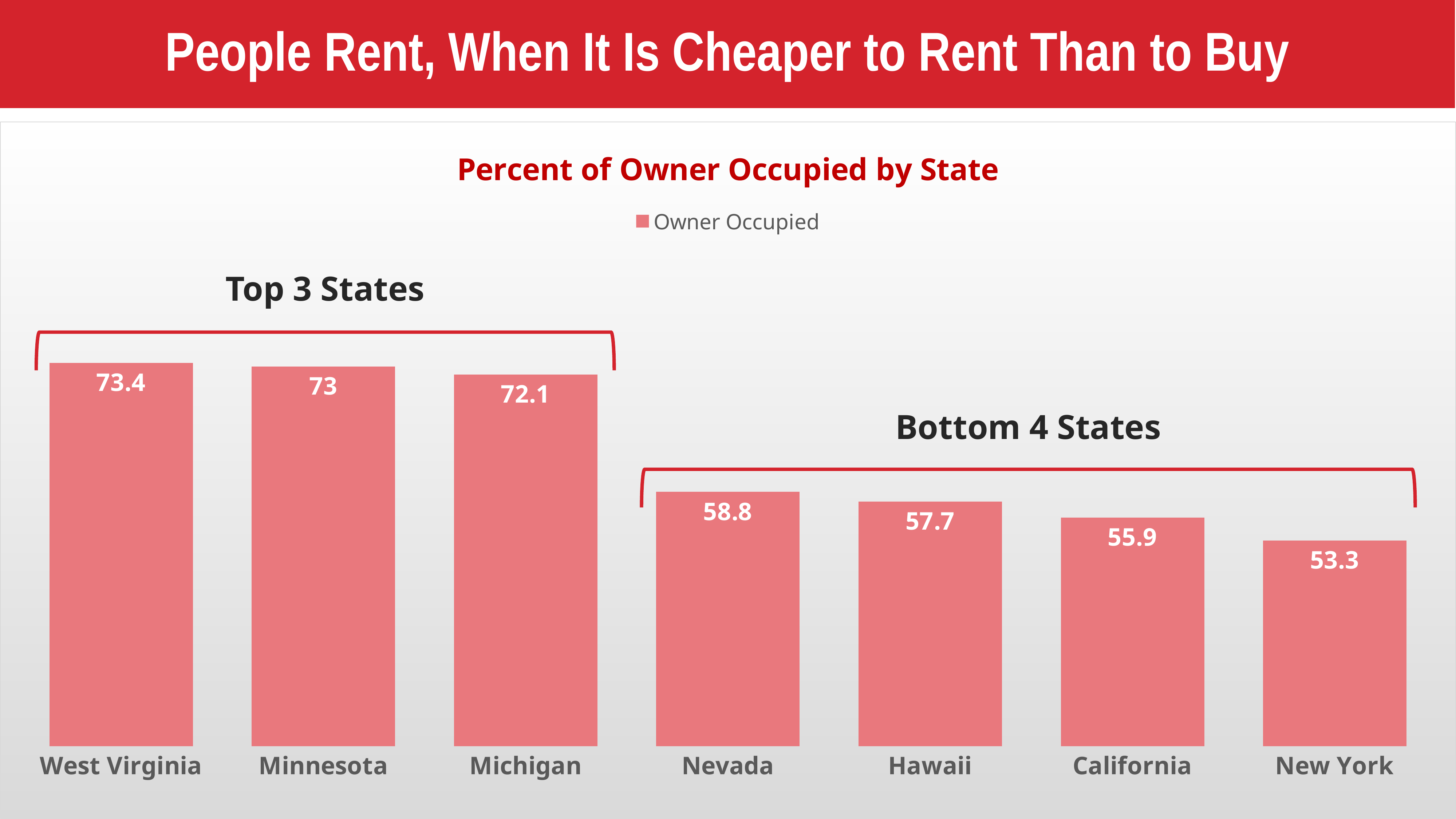
What is the Owner Occupied value for West Virginia? 73.4 Which has a larger Owner Occupied value, Michigan or California? Michigan Which state has the lowest Owner Occupied value? New York What is the difference between the Owner Occupied values for Nevada and Hawaii? 1.1 What is the difference between the Owner Occupied values for West Virginia and New York? 20.1 Which state has the highest Owner Occupied value? West Virginia What is the Owner Occupied value for New York? 53.3 What is the title of the chart? Percent of Owner Occupied by State How many states are shown in the chart? 7 How many series does the legend list? 1 What is the Owner Occupied value for Nevada? 58.8 What kind of chart is shown on the slide? Bar chart